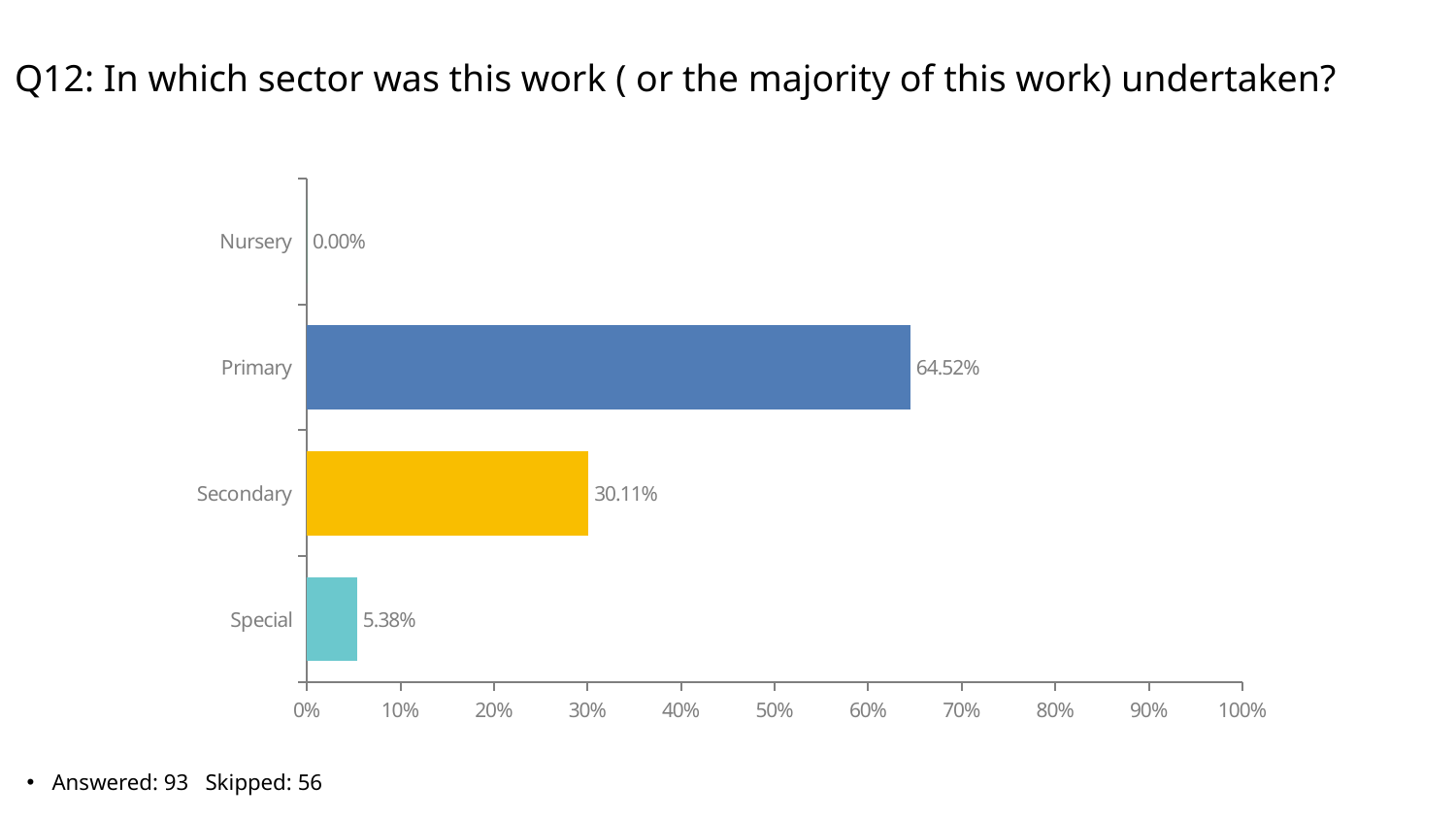
What percentage is shown for Secondary? 30.11% Which sector has the lowest percentage? Nursery What percentage is shown for Nursery? 0.00% What percentage is shown for Special? 5.38% What percentage is shown for Primary? 64.52% How many sectors are shown on the chart? 4 What kind of chart is shown on the slide? Bar chart What colour is the bar for Secondary? Yellow Is the value for Primary greater or less than 60%? greater What is the difference between the Primary and Secondary percentages? 34.41% Which sector has the highest percentage? Primary Which is larger, the value for Secondary or the value for Special? Secondary